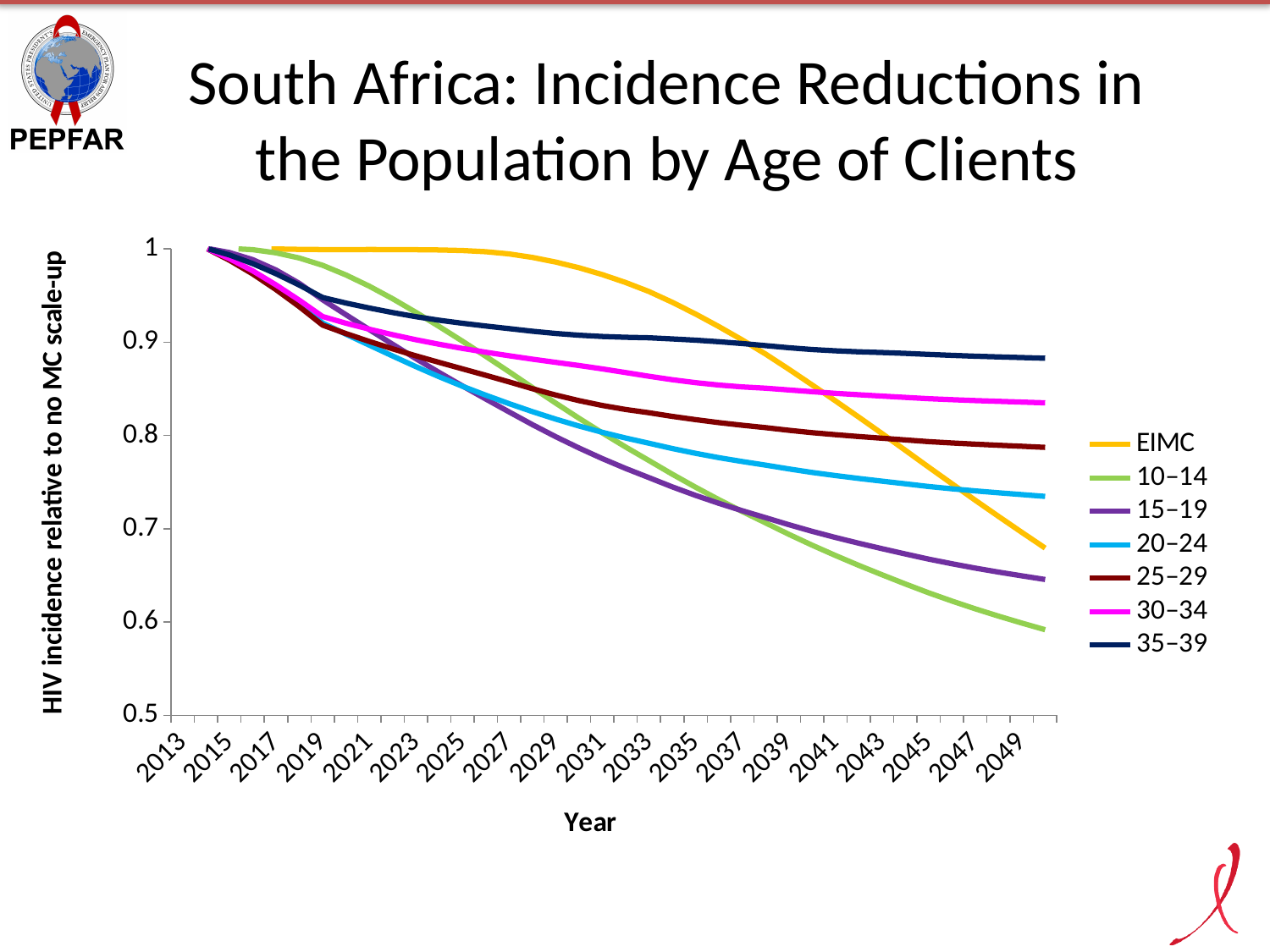
What is the title of the chart on the slide? South Africa: Incidence Reductions in the Population by Age of Clients Which series has the lowest value at the right end of the chart (2049)? 10–14 Is the value for the 15–19 series in 2049 greater or less than 0.7? less Which series has the highest value at the right end of the chart (2049)? 35–39 What kind of chart is shown on the slide? line chart Is the value for the 30–34 series in 2049 greater or less than 0.8? greater Do the values for the 10–14 series rise or fall over the years shown? fall What is the label of the vertical axis? HIV incidence relative to no MC scale-up In 2049, which series has the larger value, 35–39 or 10–14? 35–39 How many series does the legend list? 7 Is the value for the EIMC series in 2025 greater or less than 0.9? greater